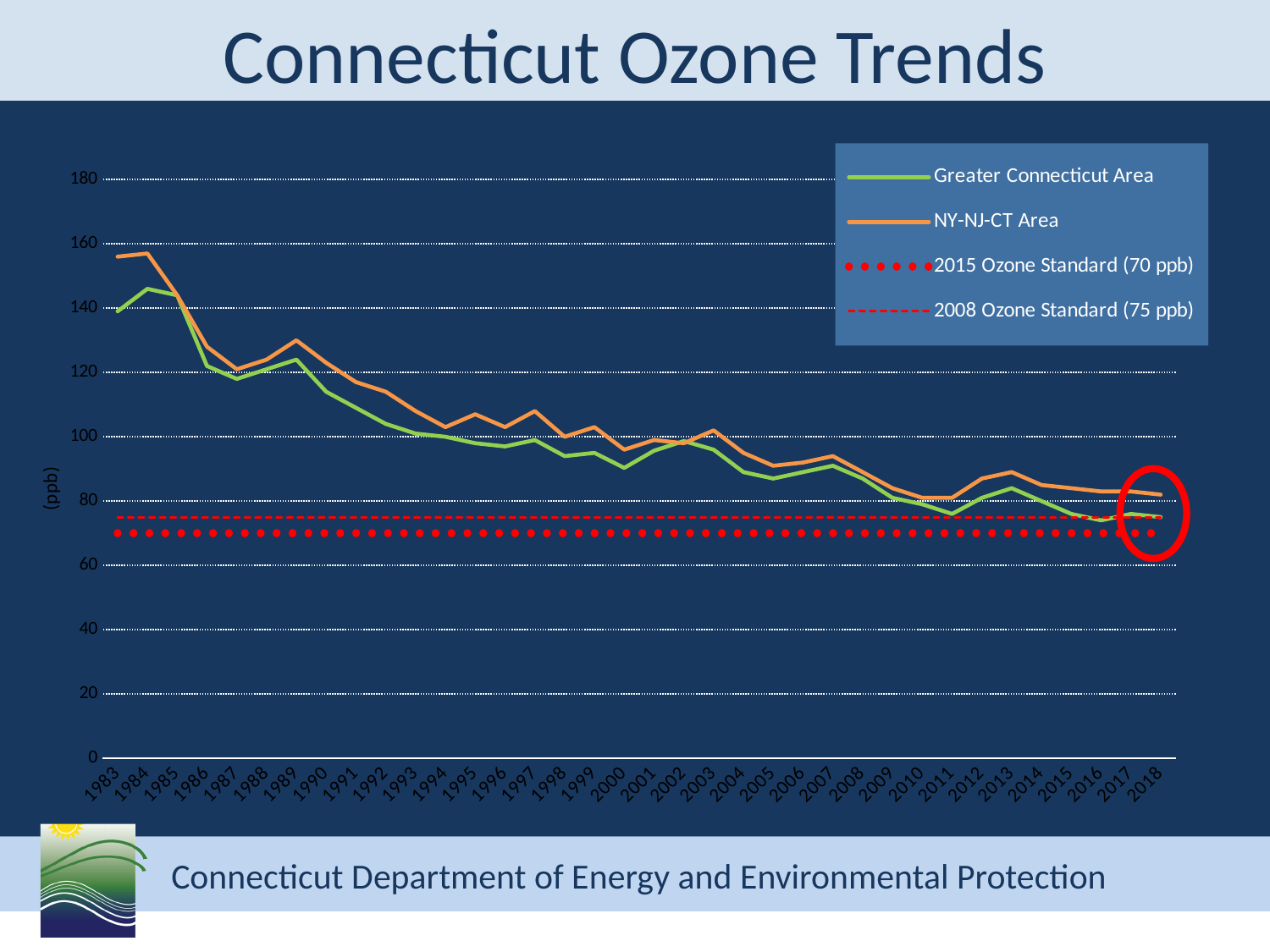
How many entries does the legend list? 4 In 1983, which series has the higher value, Greater Connecticut Area or NY-NJ-CT Area? NY-NJ-CT Area In which year does the Greater Connecticut Area series reach its highest value? 1984 How many years are shown along the x axis? 36 Is the Greater Connecticut Area value for 1983 greater or less than 120? greater What is the title of the chart? Connecticut Ozone Trends What value is the 2015 Ozone Standard line set at? 70 ppb What kind of chart is shown on the slide? line chart Do the Greater Connecticut Area values generally rise or fall from 1983 to 2018? fall Is the NY-NJ-CT Area value for 1984 greater or less than 140? greater Is the Greater Connecticut Area value for 2011 greater or less than 80? less What value is the 2008 Ozone Standard line set at? 75 ppb